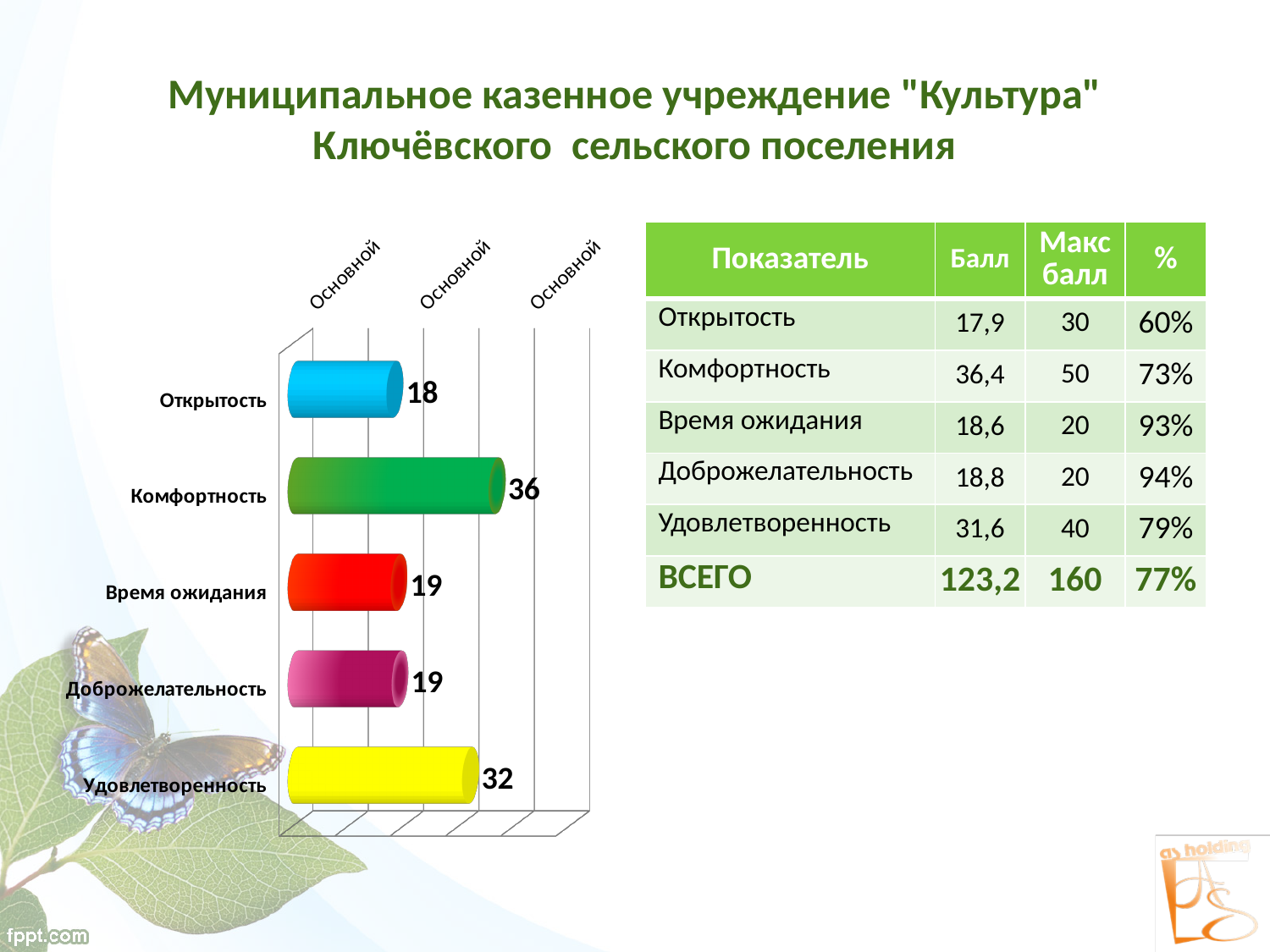
Which category has the highest value in the chart? Комфортность What is the value for Удовлетворенность in the chart? 32 Which is larger, the value for Комфортность or the value for Удовлетворенность? Комфортность What is the difference between the values for Комфортность and Удовлетворенность? 4 What colour is the bar for Удовлетворенность? Yellow What is the difference between the values for Удовлетворенность and Открытость? 14 What type of chart is shown on the slide? Bar chart How many categories are shown in the chart? 5 What is the value for Комфортность in the chart? 36 What is the value for Открытость in the chart? 18 Which category has the lowest value in the chart? Открытость What is the value for Время ожидания in the chart? 19